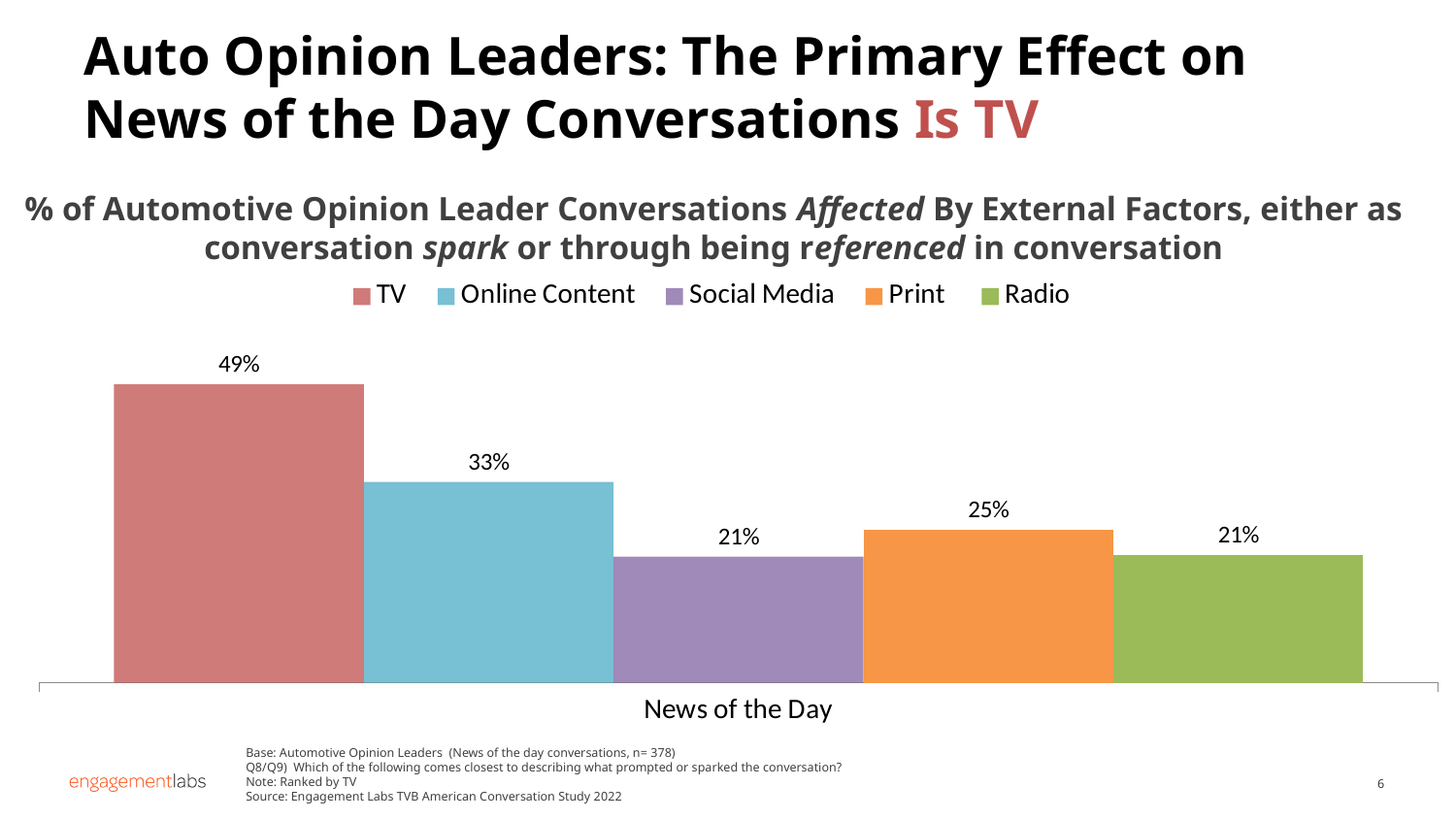
How many series does the legend list? 5 What is the difference between the Print and Radio values? 4% Which colour represents Radio in the legend? Green What percentage is shown for TV in the News of the Day chart? 49% What value is shown for Social Media? 21% What is the difference between the TV and Online Content percentages? 16% What value is shown for Online Content? 33% Which external factor has the highest percentage? TV Which is larger, the value for Print or the value for Social Media? Print What is the category label shown on the x axis? News of the Day What percentage is shown for Print? 25% What kind of chart is shown on the slide? Bar chart